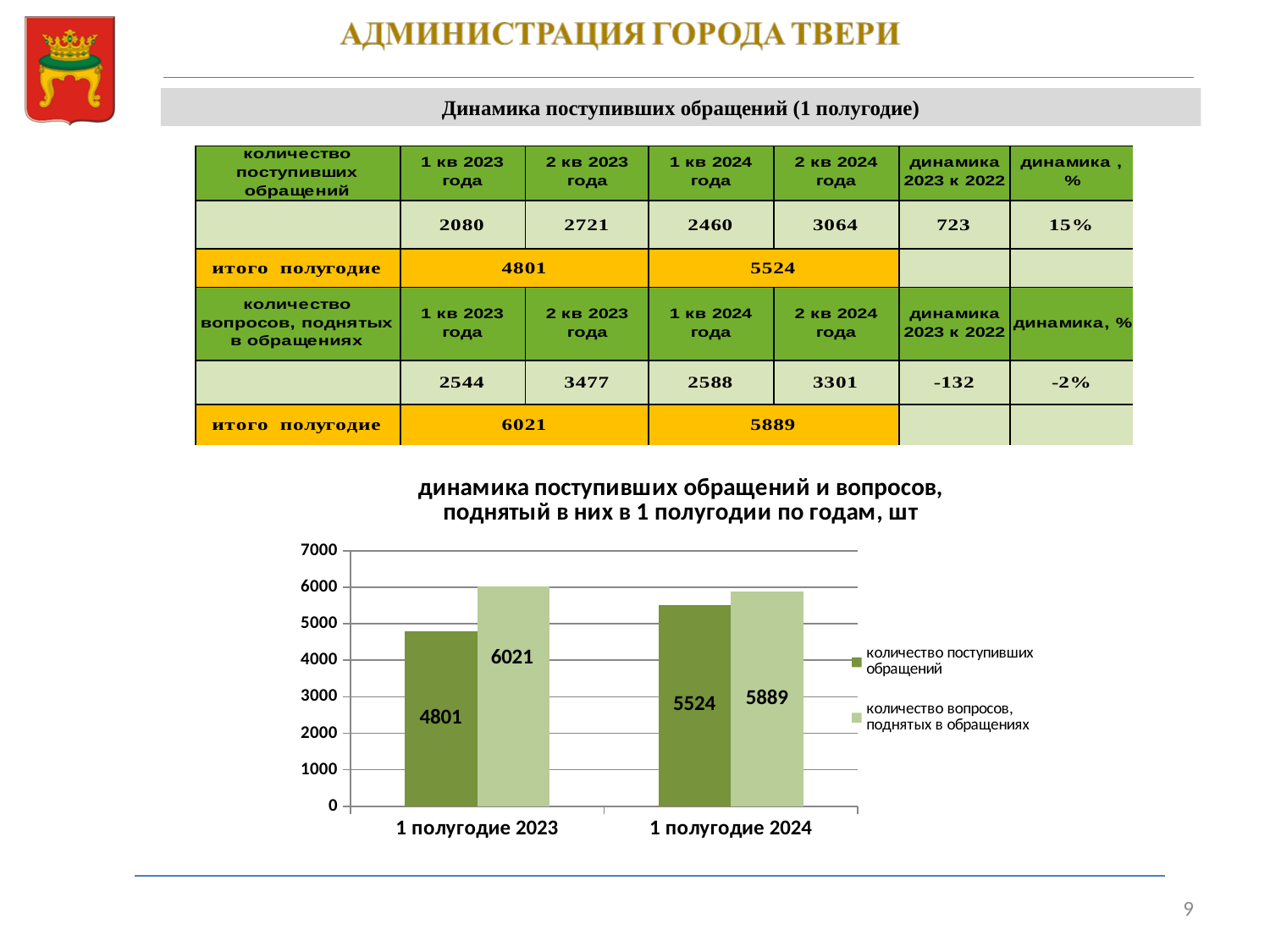
What is the difference between "количество поступивших обращений" in 1 полугодие 2024 and in 1 полугодие 2023? 723 How many series does the legend list? 2 What type of chart is shown on the slide? bar chart What is the value of "количество вопросов, поднятых в обращениях" for 1 полугодие 2023? 6021 How many categories are shown on the x axis? 2 What is the value of "количество вопросов, поднятых в обращениях" for 1 полугодие 2024? 5889 Does "количество поступивших обращений" rise or fall from 1 полугодие 2023 to 1 полугодие 2024? rise What is the value of "количество поступивших обращений" for 1 полугодие 2023? 4801 Which bar has the highest value in the chart? количество вопросов, поднятых в обращениях, 1 полугодие 2023 What is the value of "количество поступивших обращений" for 1 полугодие 2024? 5524 Which bar has the lowest value in the chart? количество поступивших обращений, 1 полугодие 2023 Which is larger: "количество вопросов, поднятых в обращениях" in 1 полугодие 2023 or in 1 полугодие 2024? 1 полугодие 2023